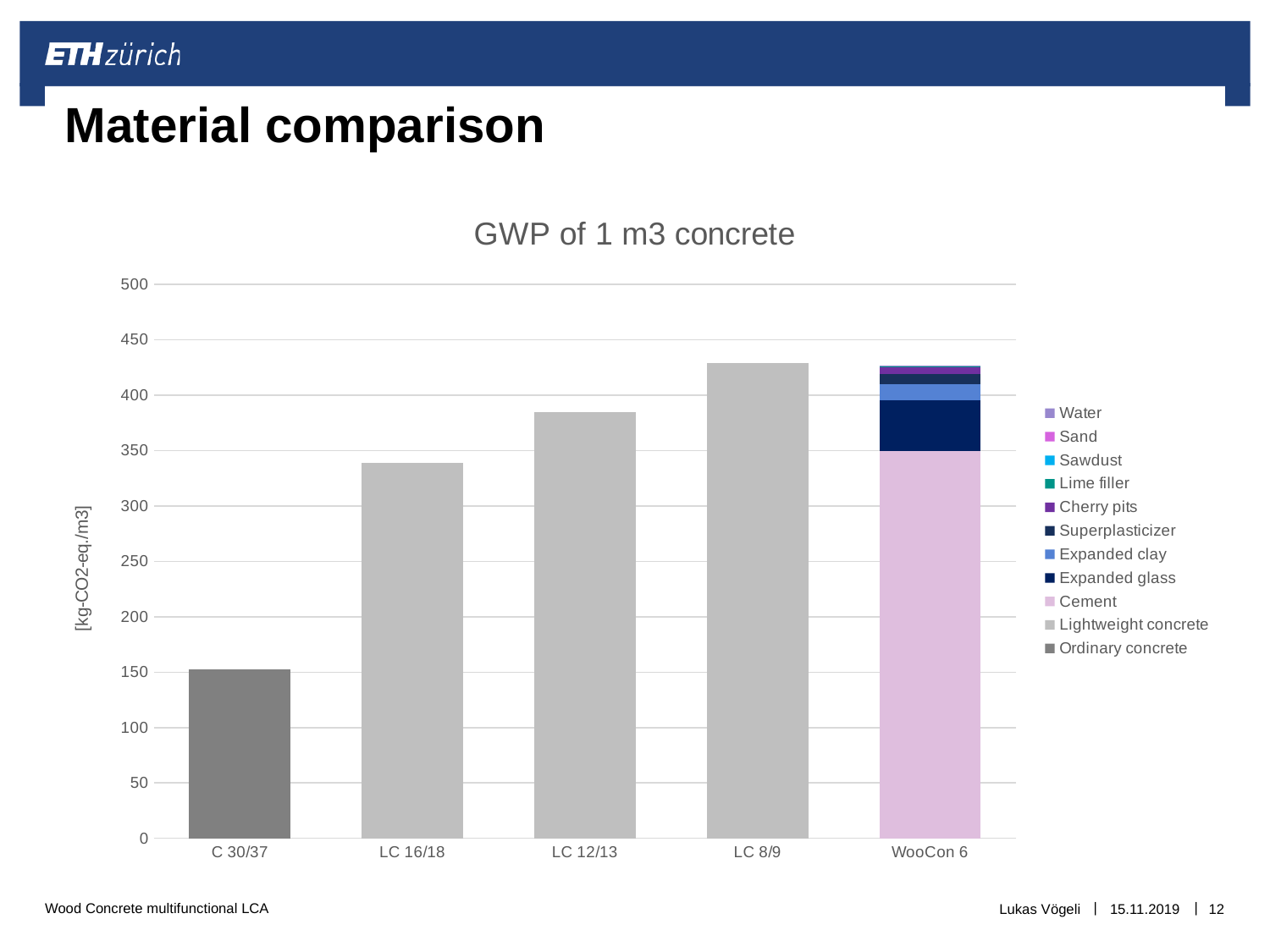
How many concrete types (categories) are shown on the x axis? 5 Is the value for LC 12/13 greater or less than 400? less Is the value for C 30/37 greater or less than 200? less What is the title of the chart? GWP of 1 m3 concrete What type of chart is shown on the slide? Stacked bar chart Which has a higher GWP, LC 16/18 or LC 12/13? LC 12/13 Is the Cement segment of the WooCon 6 bar greater or less than 300? greater What is the label on the y axis? [kg-CO2-eq./m3] Which concrete type has the lowest GWP? C 30/37 How many series does the legend list? 11